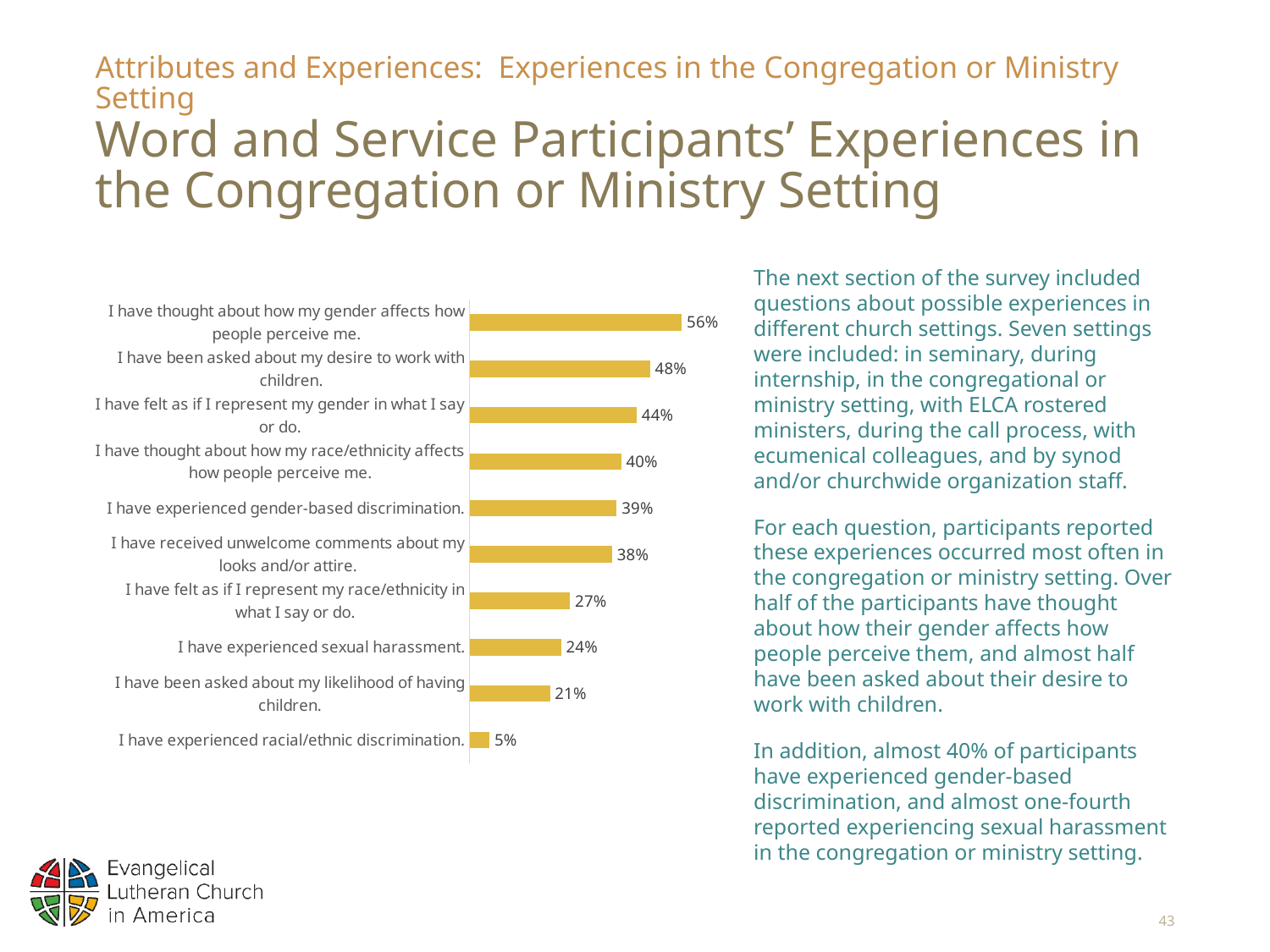
How many experience categories are shown in the chart? 10 What is the difference in percentage points between 'I have experienced gender-based discrimination' and 'I have experienced racial/ethnic discrimination'? 34 What kind of chart is shown on the slide? Bar chart What colour are the bars in the chart? Yellow/gold What percentage of participants have received unwelcome comments about their looks and/or attire? 38% What is the difference in percentage points between 'I have thought about how my gender affects how people perceive me' and 'I have thought about how my race/ethnicity affects how people perceive me'? 16 Which experience has the highest percentage in the chart? I have thought about how my gender affects how people perceive me. Which experience has the lowest percentage in the chart? I have experienced racial/ethnic discrimination. What percentage of participants have thought about how their gender affects how people perceive them? 56% What percentage of participants have been asked about their likelihood of having children? 21% What percentage of participants have experienced sexual harassment? 24% Which is larger: the percentage who have been asked about their desire to work with children, or the percentage who have felt as if they represent their gender in what they say or do? I have been asked about my desire to work with children.